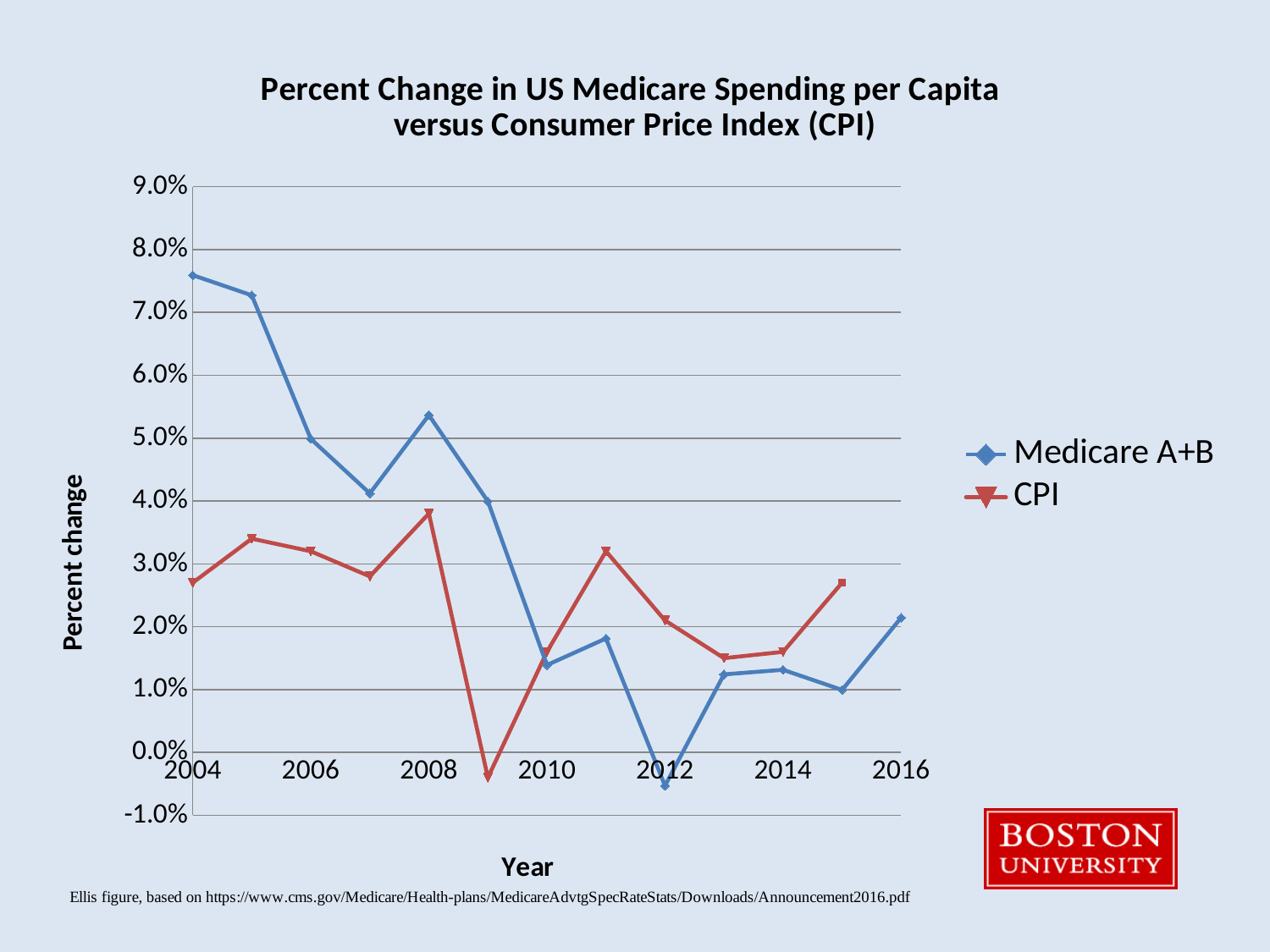
In which year is the Medicare A+B value highest? 2004 In which year is the CPI value lowest? 2009 What is the label of the vertical axis? Percent change What kind of chart is shown on the slide? Line chart Does the Medicare A+B series generally rise or fall from 2004 to 2016? fall In 2004, which series has the larger value, Medicare A+B or CPI? Medicare A+B Is the Medicare A+B value for 2004 greater or less than 7.0%? greater Is the Medicare A+B value for 2010 greater or less than 2.0%? less Which two series are listed in the legend? Medicare A+B and CPI Is the CPI value for 2008 greater or less than 3.0%? greater In which year is the Medicare A+B value lowest? 2012 How many series does the legend list? 2